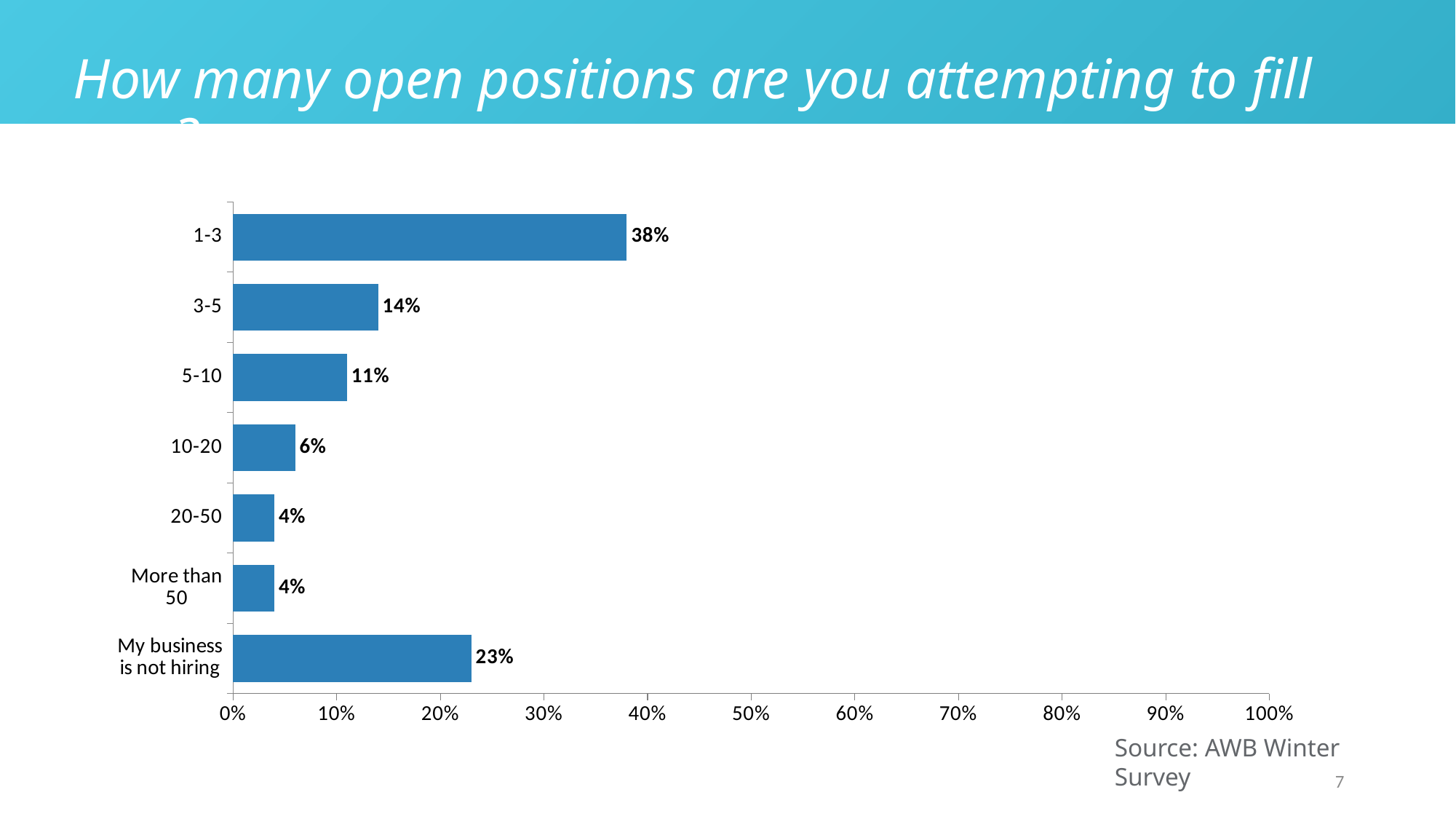
What is the value for the 'My business is not hiring' category? 23% Which is larger, the value for 3-5 or the value for 'My business is not hiring'? My business is not hiring What kind of chart is shown on the slide? Bar chart What percentage of respondents are attempting to fill 1-3 open positions? 38% What is the difference between the values for 1-3 and 3-5? 24% What is the value for the 10-20 category? 6% What percentage of respondents are attempting to fill 5-10 open positions? 11% What is the difference between the values for 'My business is not hiring' and 5-10? 12% What is the source cited for the chart? AWB Winter Survey Is the value for 1-3 greater or less than 30%? greater Which category has the highest value? 1-3 How many categories are shown on the chart? 7